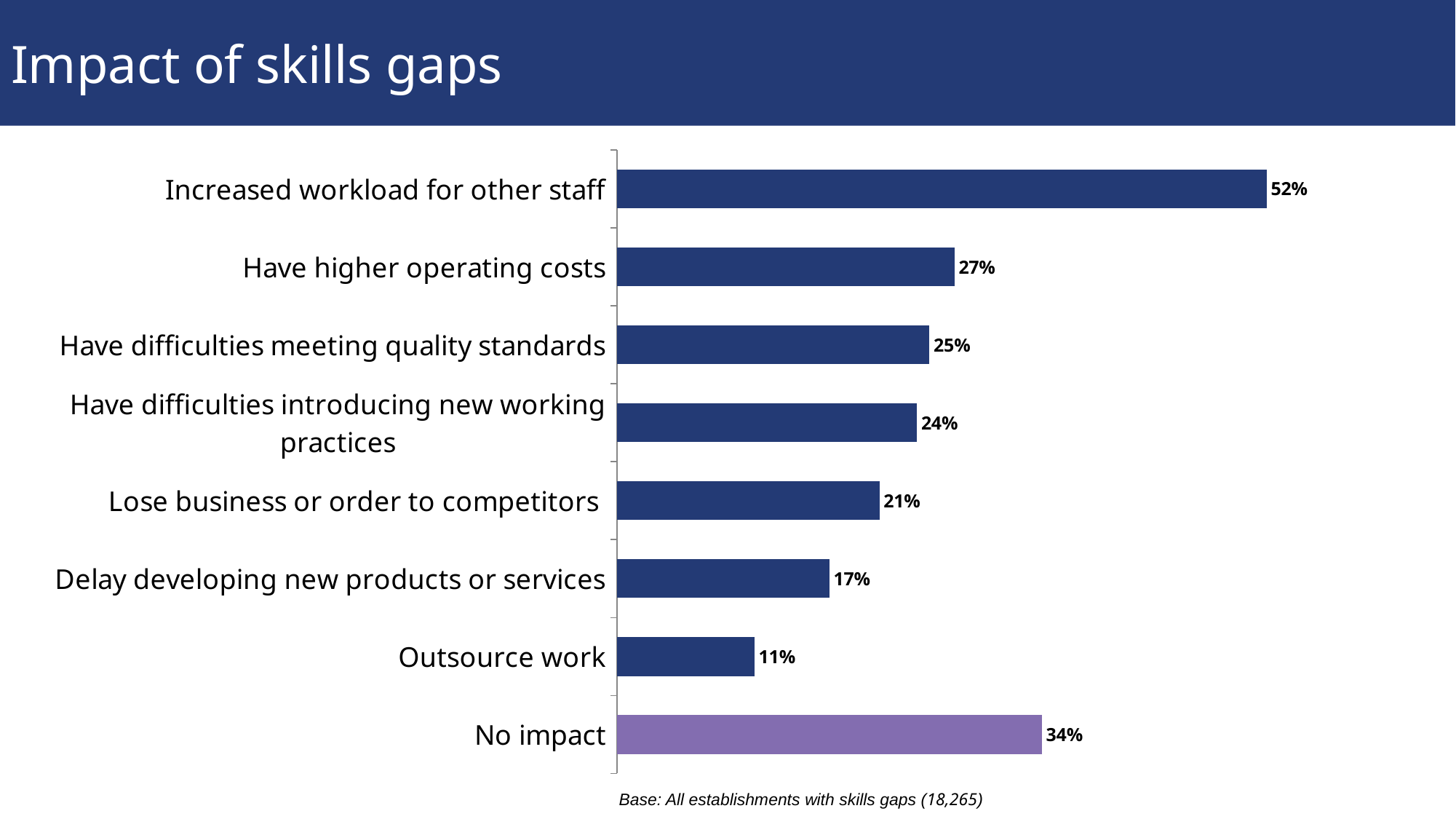
What percentage of establishments reported increased workload for other staff as an impact of skills gaps? 52% Which category has the lowest value on the chart? Outsource work What is the difference between the values for 'Increased workload for other staff' and 'Have higher operating costs'? 25 percentage points What is the difference between the values for 'No impact' and 'Outsource work'? 23 percentage points Which is larger: the value for 'Lose business or order to competitors' or the value for 'Delay developing new products or services'? Lose business or order to competitors What is the value shown for 'Outsource work'? 11% What kind of chart is shown on the slide? Bar chart What percentage of establishments reported no impact from skills gaps? 34% What is the base stated below the chart? All establishments with skills gaps (18,265) Which bar is shown in a different colour (purple) from the others? No impact How many categories are shown on the chart? 8 Which category has the highest value on the chart? Increased workload for other staff